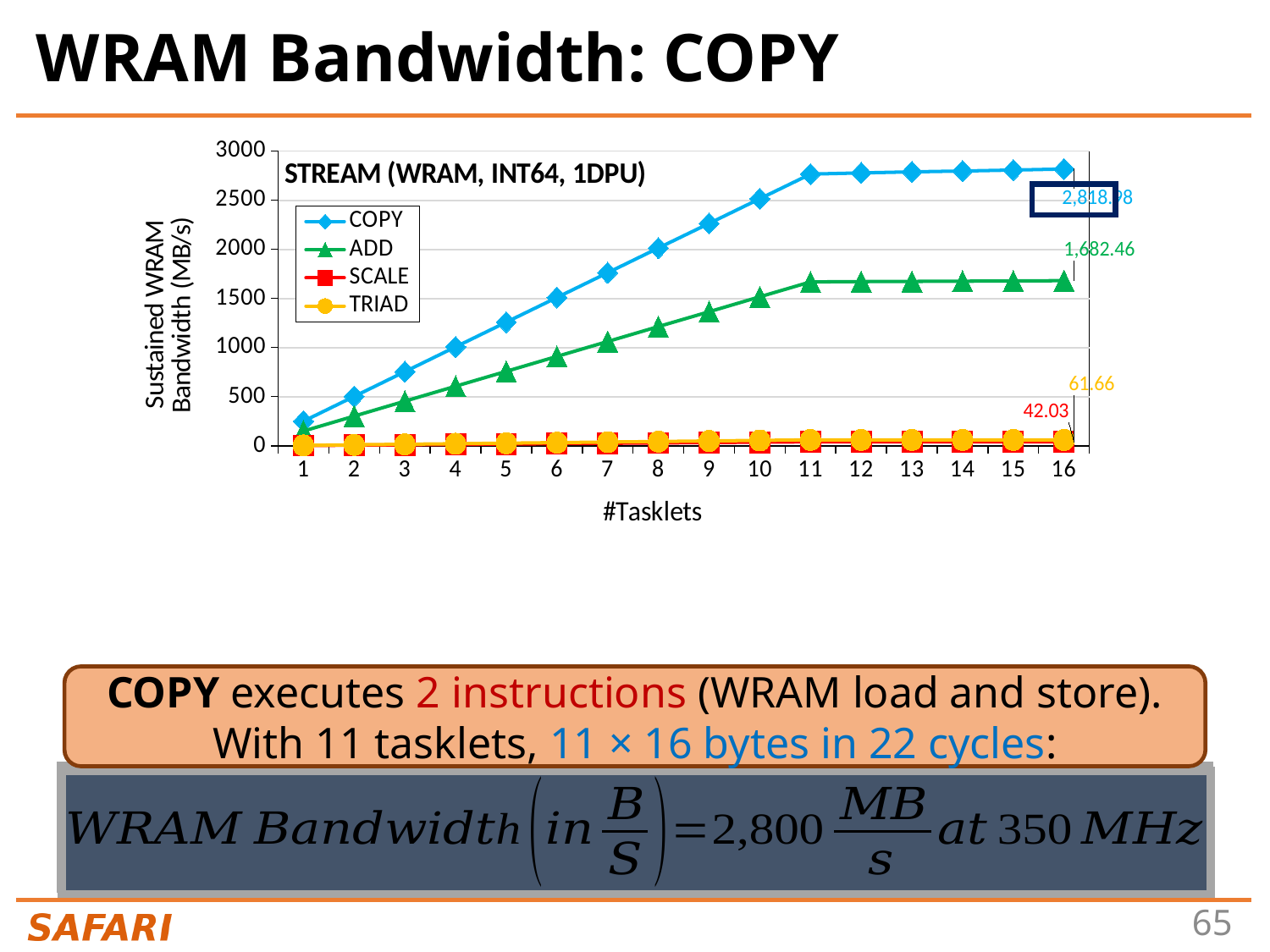
Which series has the highest sustained WRAM bandwidth at 16 tasklets? COPY What is the difference between the TRIAD and SCALE bandwidth values at 16 tasklets? 19.63 What is the sustained WRAM bandwidth for ADD at 16 tasklets? 1,682.46 Is the ADD bandwidth at 5 tasklets greater or less than 1000? less Which series has the lowest sustained WRAM bandwidth at 16 tasklets? SCALE What is the sustained WRAM bandwidth for TRIAD at 16 tasklets? 61.66 Is the COPY bandwidth at 11 tasklets greater or less than 2500? greater What is the label of the x axis? #Tasklets How many #Tasklets values are plotted along the x axis? 16 What type of chart is shown on the slide? line chart How many series does the chart legend list? 4 What is the sustained WRAM bandwidth for SCALE at 16 tasklets? 42.03